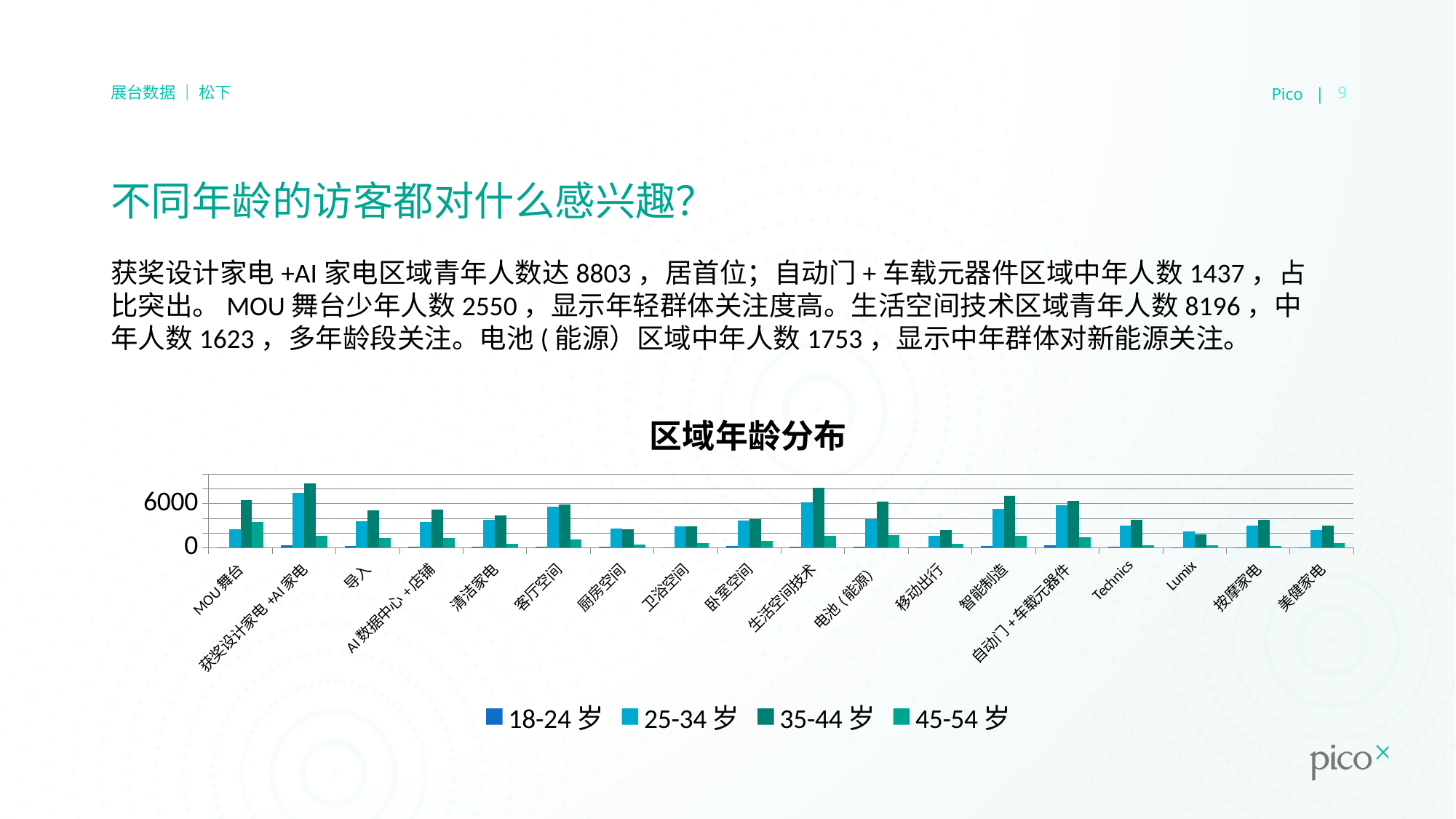
Is the value for 35-44 岁 in 厨房空间 greater or less than 6000? less How many series does the legend list? 4 Which category has the highest value for 35-44 岁? 获奖设计家电 +AI 家电 What kind of chart is shown on the slide? bar chart Is the value for 35-44 岁 in 获奖设计家电 +AI 家电 greater or less than 6000? greater Which age group is listed first in the legend? 18-24 岁 In MOU 舞台, which is larger: the 35-44 岁 value or the 45-54 岁 value? 35-44 岁 Is the value for 35-44 岁 in 生活空间技术 greater or less than 6000? greater In 获奖设计家电 +AI 家电, which is larger: the 25-34 岁 value or the 35-44 岁 value? 35-44 岁 What is the title of the chart? 区域年龄分布 How many categories are shown along the x axis of the chart? 18